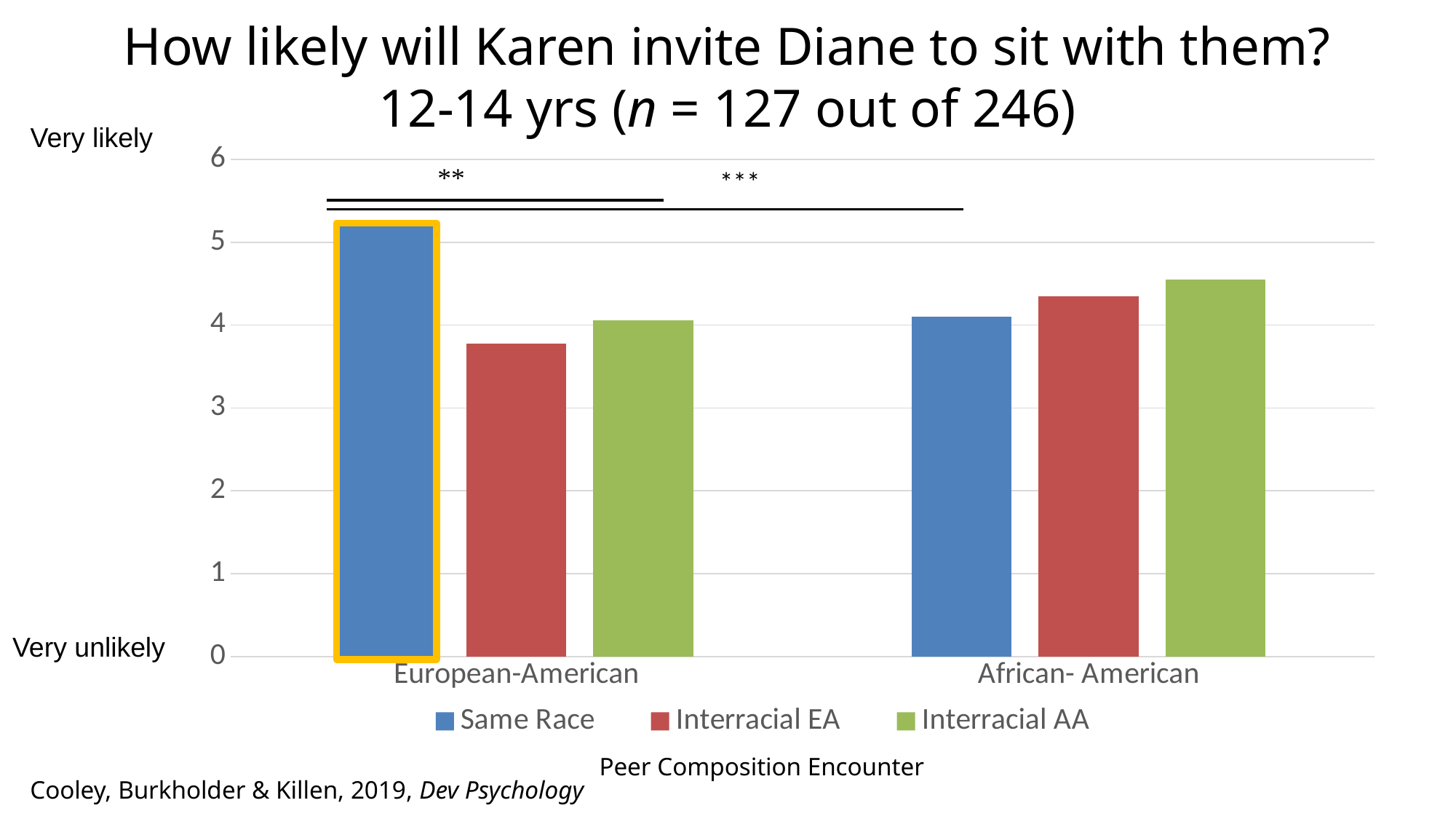
Which series has the highest bar in the European-American group? Same Race How many series does the legend list? 3 Is the Interracial EA value for African- American greater or less than 4? greater In the African- American group, which is larger: the Same Race bar or the Interracial AA bar? Interracial AA Which series has the highest bar in the African- American group? Interracial AA Which series has the lowest bar in the European-American group? Interracial EA What kind of chart is shown on the slide? bar chart Is the Same Race value for European-American greater or less than 5? greater Is the Interracial EA value for European-American greater or less than 4? less What is the x-axis title of the chart? Peer Composition Encounter In the European-American group, which is larger: the Same Race bar or the Interracial EA bar? Same Race How many peer composition categories are shown on the x axis? 2